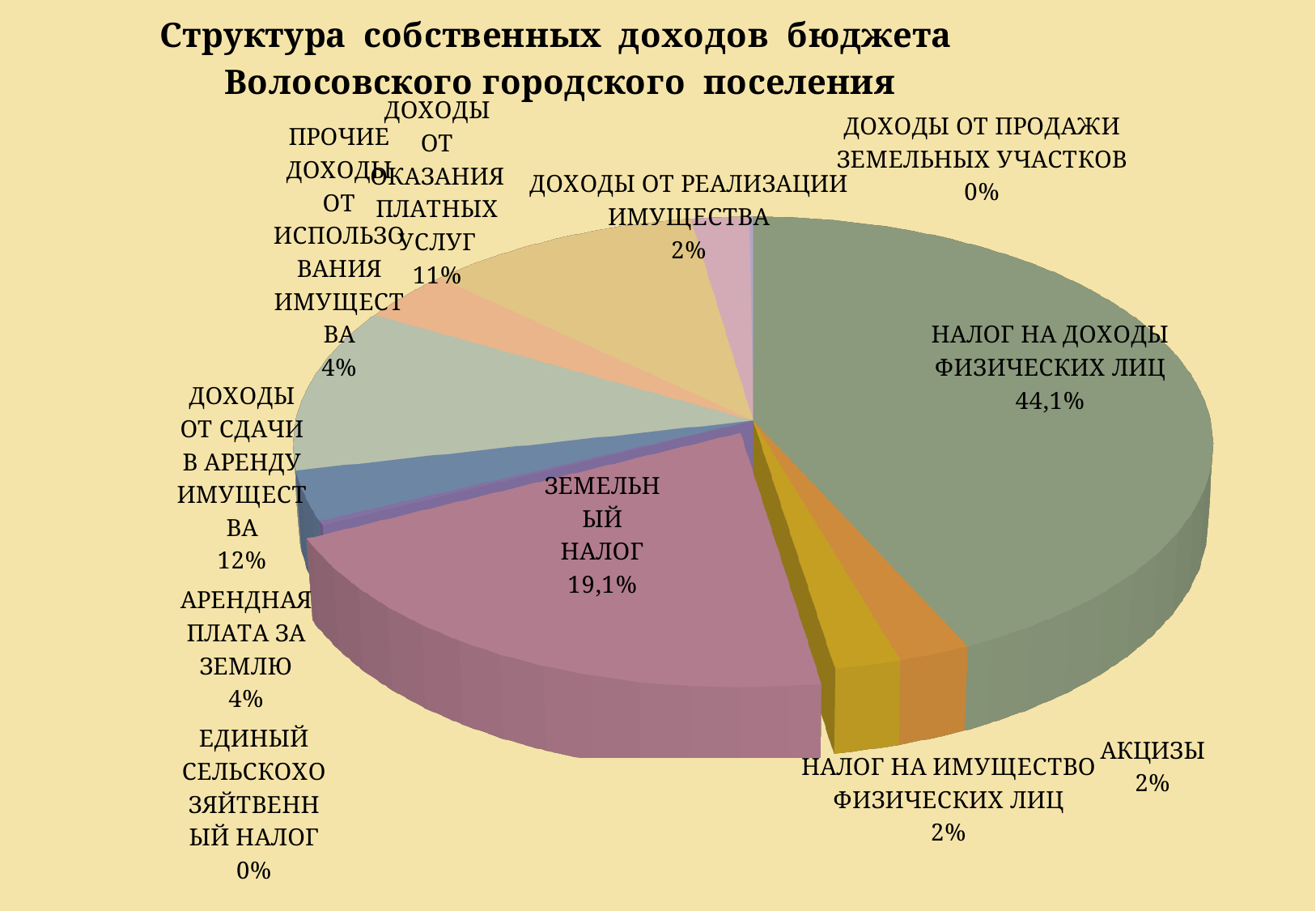
What is the difference between the shares of НАЛОГ НА ДОХОДЫ ФИЗИЧЕСКИХ ЛИЦ and ЗЕМЕЛЬНЫЙ НАЛОГ? 25 percentage points Which category has the largest share of the pie? НАЛОГ НА ДОХОДЫ ФИЗИЧЕСКИХ ЛИЦ What share of the pie is АРЕНДНАЯ ПЛАТА ЗА ЗЕМЛЮ? 4% What type of chart is shown on the slide? Pie chart What share of the pie is ЗЕМЕЛЬНЫЙ НАЛОГ? 19,1% How many categories are shown in the pie chart? 11 What share of the pie is ДОХОДЫ ОТ ОКАЗАНИЯ ПЛАТНЫХ УСЛУГ? 11% Which is larger: the share of ДОХОДЫ ОТ СДАЧИ В АРЕНДУ ИМУЩЕСТВА or the share of ДОХОДЫ ОТ ОКАЗАНИЯ ПЛАТНЫХ УСЛУГ? ДОХОДЫ ОТ СДАЧИ В АРЕНДУ ИМУЩЕСТВА What share of the pie is ДОХОДЫ ОТ ПРОДАЖИ ЗЕМЕЛЬНЫХ УЧАСТКОВ? 0% What share of the pie is ДОХОДЫ ОТ СДАЧИ В АРЕНДУ ИМУЩЕСТВА? 12% What share of the pie is НАЛОГ НА ДОХОДЫ ФИЗИЧЕСКИХ ЛИЦ? 44,1% What is the title of the chart? Структура собственных доходов бюджета Волосовского городского поселения